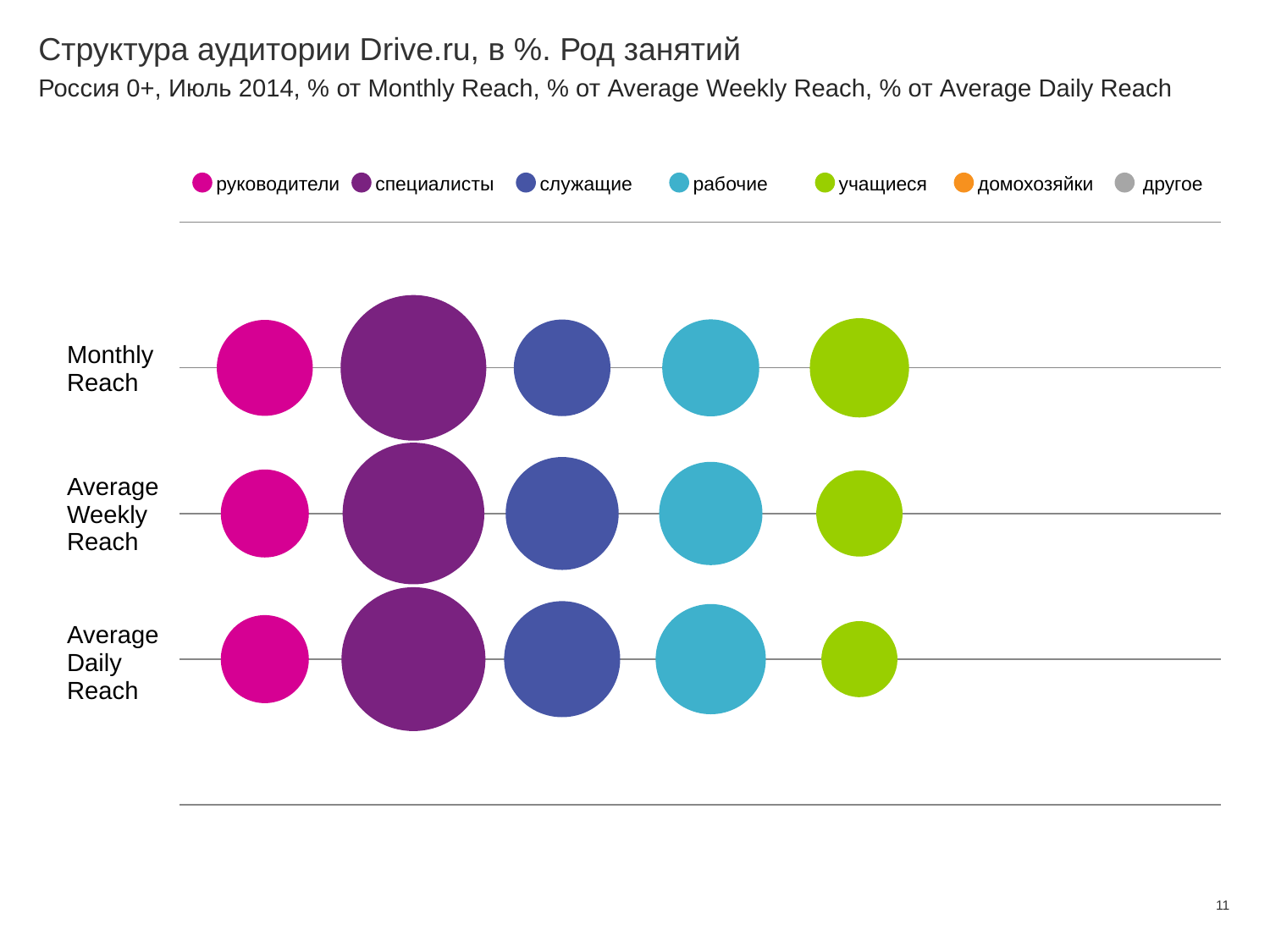
In the Average Daily Reach row, which bubble is larger: служащие or учащиеся? служащие What is the title of the chart on the slide? Структура аудитории Drive.ru, в %. Род занятий Among the visible bubbles in the Average Daily Reach row, which occupation group has the smallest bubble? учащиеся How many reach categories (rows) are plotted on the chart? 3 In the Average Weekly Reach row, which bubble is larger: специалисты or руководители? специалисты Does the bubble for учащиеся get larger or smaller going from Monthly Reach to Average Daily Reach? smaller How many series does the legend list? 7 Which occupation group has the largest bubble in the Monthly Reach row? специалисты Which occupation group has the largest bubble in the Average Daily Reach row? специалисты What kind of chart is shown on the slide? bubble chart Does the bubble for служащие get larger or smaller going from Monthly Reach to Average Daily Reach? larger Which legend entry is shown in orange? домохозяйки